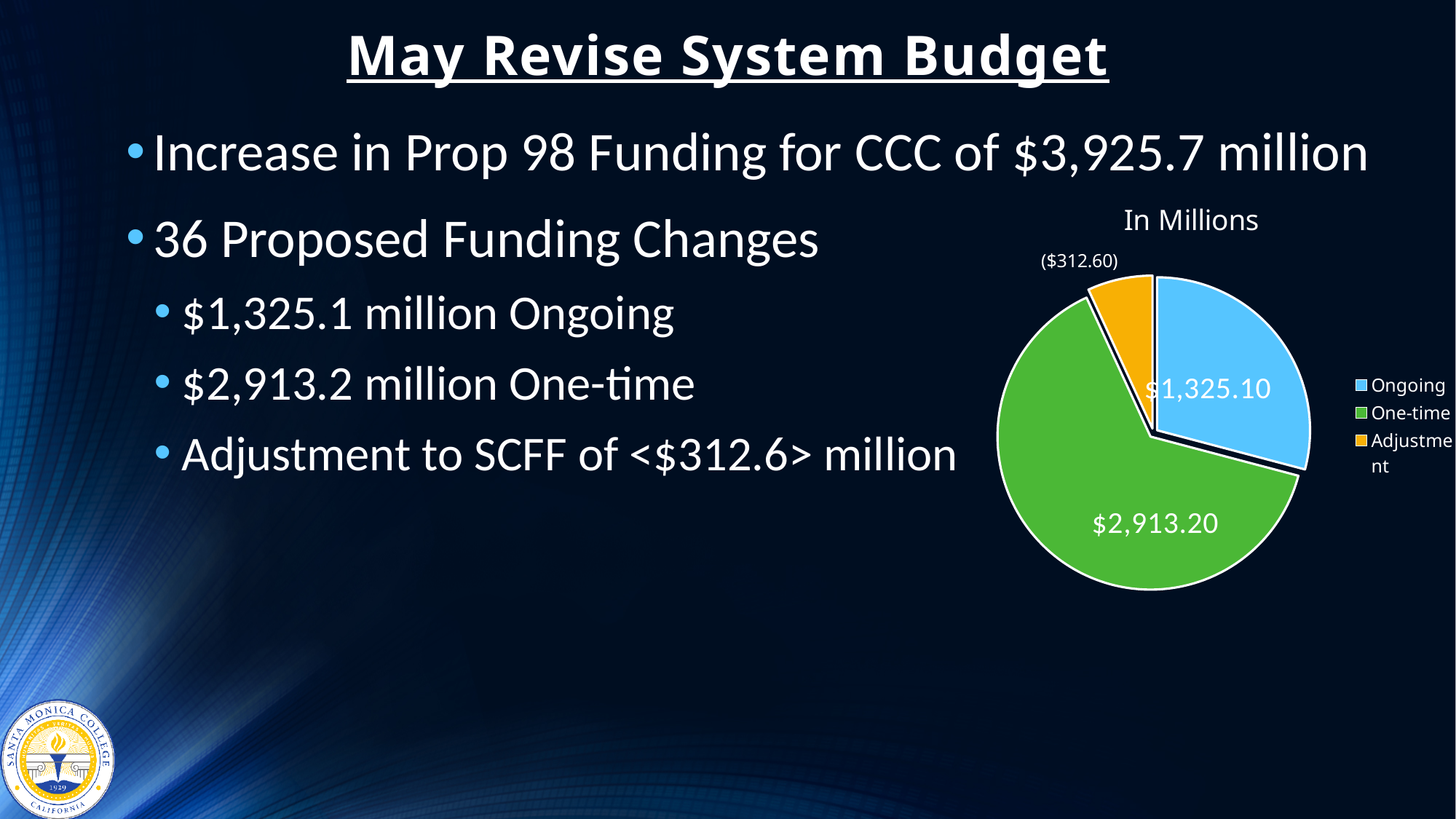
What kind of chart is shown on the slide? pie chart What is the difference between the One-time value and the Ongoing value in the pie chart? $1,588.10 What is the value of the One-time slice in the pie chart? $2,913.20 What colour is the One-time slice in the pie chart? green Which category has the smallest slice in the pie chart? Adjustment How many entries does the chart legend list? 3 Which is larger in the pie chart, the Ongoing slice or the One-time slice? One-time Which category has the largest slice in the pie chart? One-time How many slices does the pie chart have? 3 What is the value of the Ongoing slice in the pie chart? $1,325.10 What is the title of the chart? In Millions What value is labelled on the Adjustment slice of the pie chart? ($312.60)